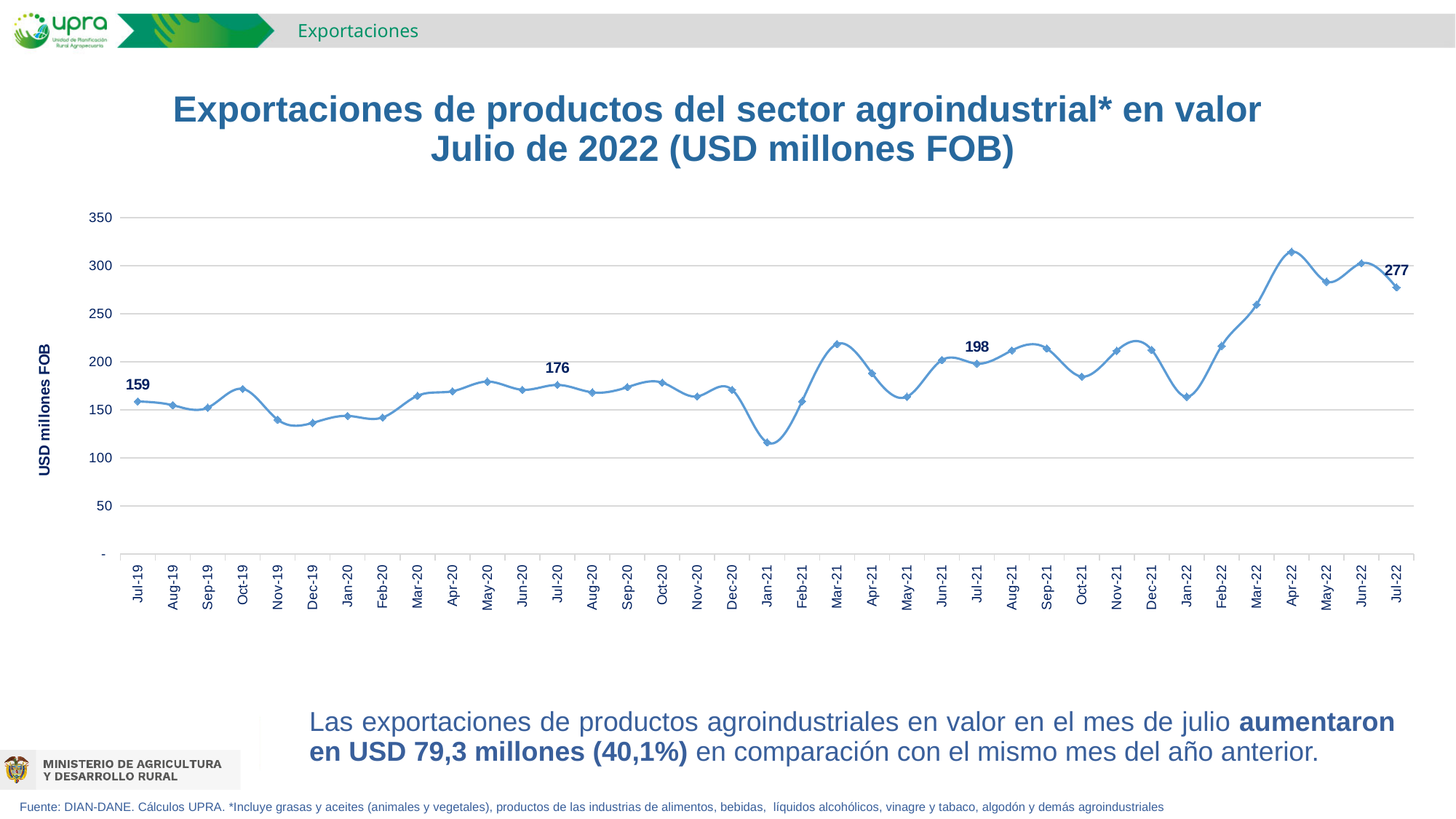
What is the value for Jul-20? 176 Which month has the lowest value on the chart? Jan-21 Is the value for Jan-21 greater or less than 150? less What is the difference between the values for Jul-22 and Jul-21? 79 Is the value for Apr-22 greater or less than 300? greater What is the value for Jul-21? 198 What is the value for Jul-19? 159 What is the label of the vertical axis? USD millones FOB What type of chart is shown on the slide? Line chart What is the value for Jul-22? 277 Which month has the highest value on the chart? Apr-22 What is the difference between the values for Jul-21 and Jul-20? 22